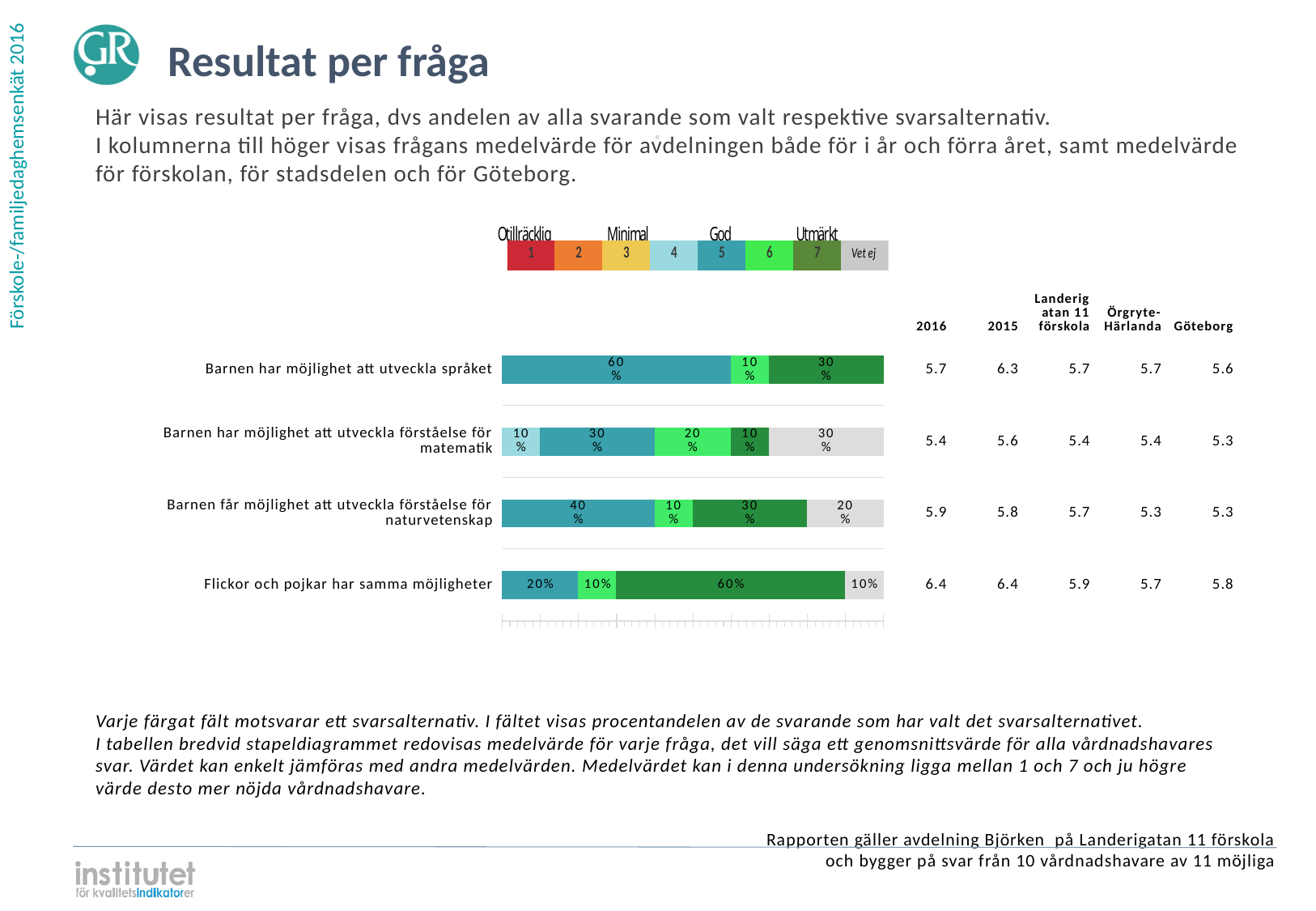
What kind of chart is used to show the results per question on this slide? Stacked horizontal bar chart Which question has the smallest dark green segment? Barnen har möjlighet att utveckla förståelse för matematik How many percentage points larger is the dark green segment for 'Flickor och pojkar har samma möjligheter' than for 'Barnen får möjlighet att utveckla förståelse för naturvetenskap'? 30 percentage points What percentage is shown in the teal (5) segment for 'Barnen har möjlighet att utveckla språket'? 60% What percentage is shown in the dark green segment for 'Flickor och pojkar har samma möjligheter'? 60% How many questions (bars) are shown in the chart? 4 Which question has the largest grey 'Vet ej' segment? Barnen har möjlighet att utveckla förståelse för matematik What do the segments of the bar for 'Barnen har möjlighet att utveckla språket' add up to? 100% Which has a larger teal (5) segment: 'Barnen har möjlighet att utveckla språket' or 'Barnen får möjlighet att utveckla förståelse för naturvetenskap'? Barnen har möjlighet att utveckla språket What percentage of respondents chose 'Vet ej' (grey segment) for 'Barnen har möjlighet att utveckla förståelse för matematik'? 30% What are the four scale labels shown above the colour legend? Otillräcklig, Minimal, God, Utmärkt What percentage is shown in the light green (6) segment for 'Barnen har möjlighet att utveckla förståelse för matematik'? 20%